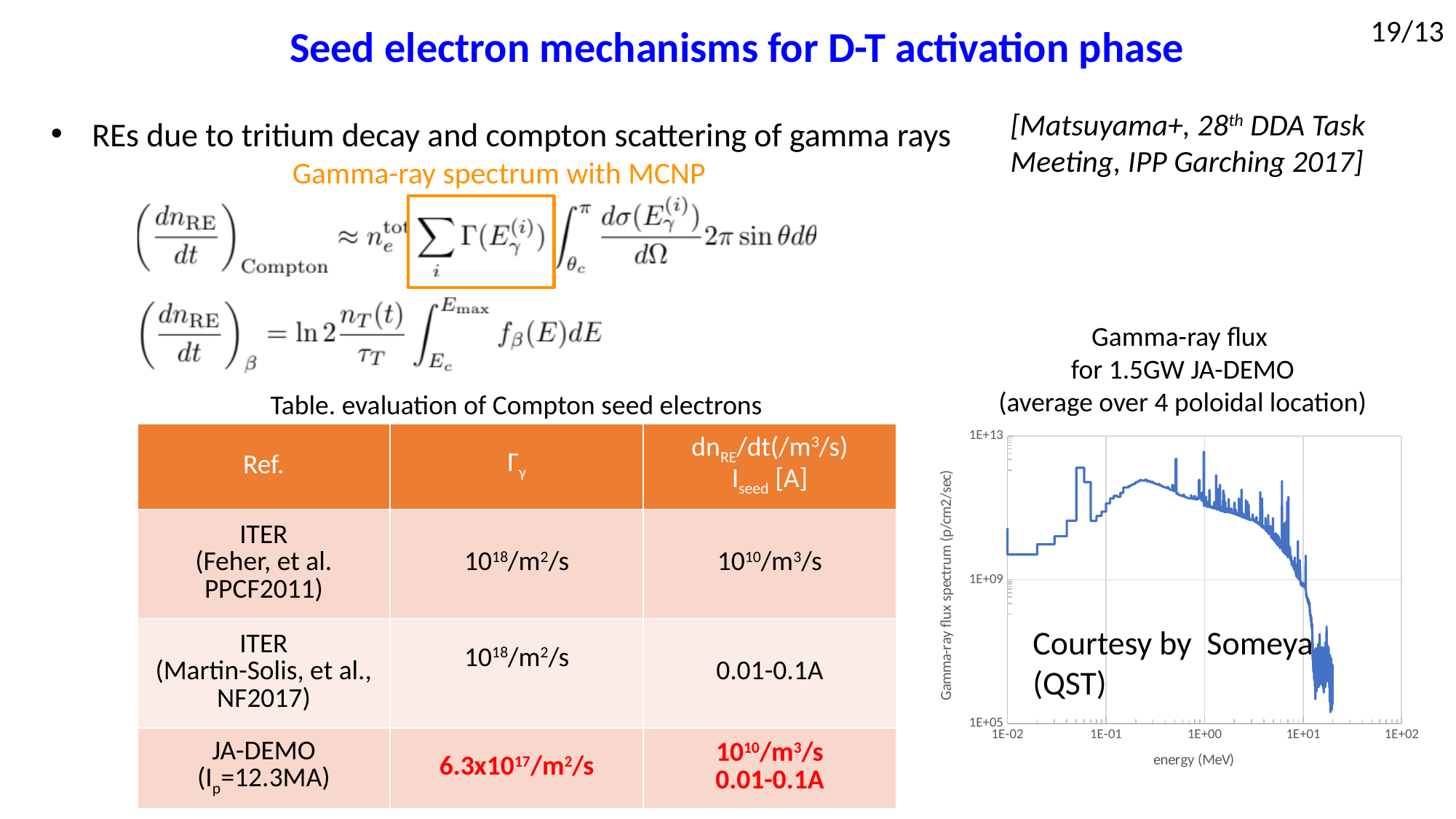
Does the gamma-ray flux rise or fall as energy increases from 1E+00 MeV to 1E+01 MeV? fall How many data series are plotted in the chart? 1 What is the title of the chart on the slide? Gamma-ray flux for 1.5GW JA-DEMO (average over 4 poloidal location) What is the highest energy value shown on the x axis of the chart? 1E+02 What is the label of the x axis of the chart? energy (MeV) Is the gamma-ray flux at an energy of 1E-02 MeV greater or less than 1E+13? less Does the gamma-ray flux rise or fall as energy increases from 1E-02 MeV to 1E-01 MeV? rise Is the gamma-ray flux at an energy of 1E+00 MeV greater or less than 1E+09? greater Is the gamma-ray flux at an energy of 1E-01 MeV greater or less than 1E+09? greater Is the gamma-ray flux higher at 1E-01 MeV or at 1E+01 MeV? 1E-01 MeV What kind of chart is shown on the slide? line chart